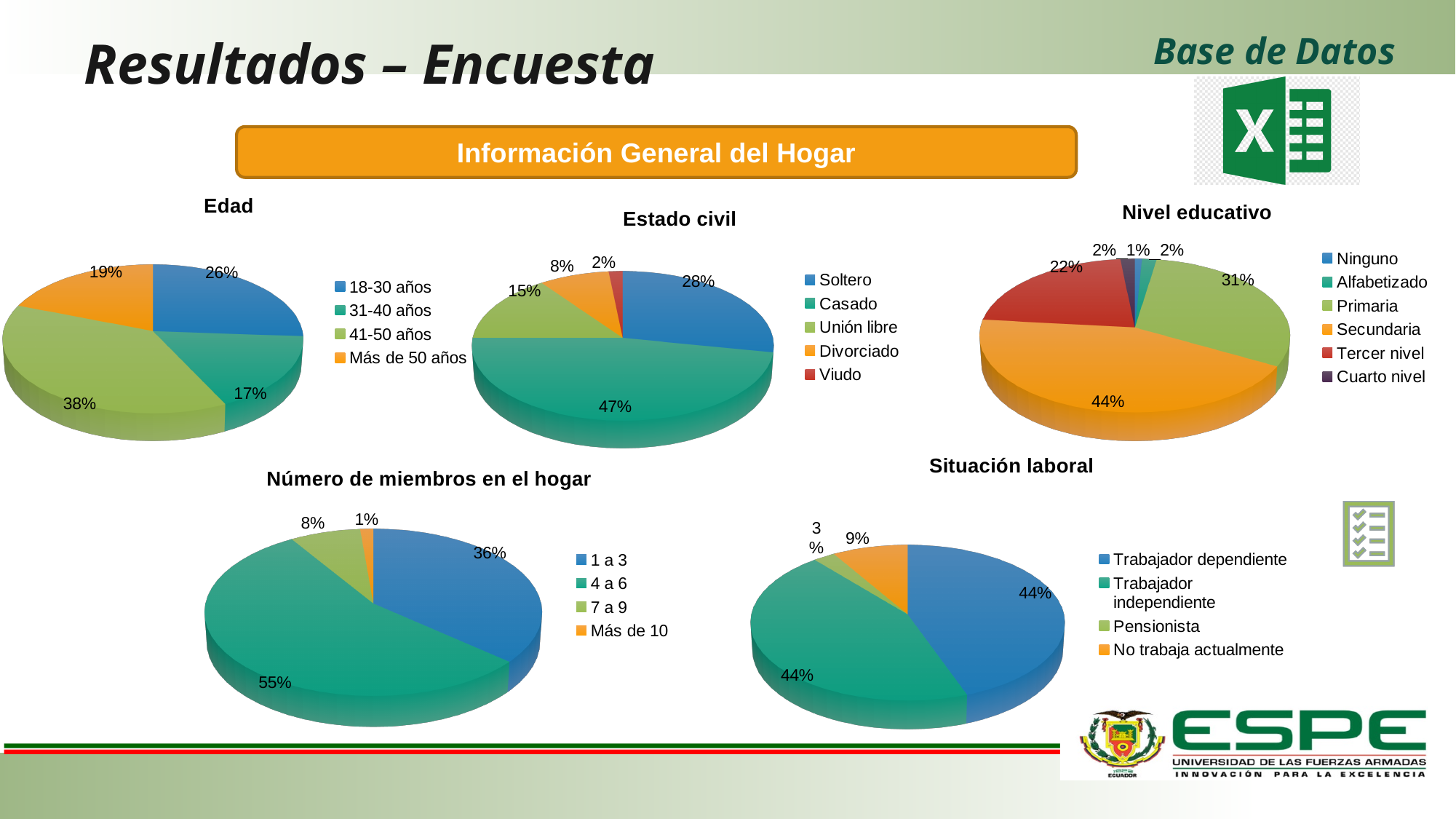
In the 'Nivel educativo' chart, which is larger, Primaria or Tercer nivel? Primaria In the 'Situación laboral' chart, what percentage is shown for No trabaja actualmente? 9% In the 'Número de miembros en el hogar' chart, what percentage is shown for 4 a 6? 55% In the 'Número de miembros en el hogar' chart, which category has the largest share? 4 a 6 How many pie charts are shown on the slide? 5 In the 'Edad' chart, which age group has the smallest share? 31-40 años In the 'Edad' chart, what percentage is shown for 41-50 años? 38% How many categories does the legend of the 'Estado civil' chart list? 5 In the 'Estado civil' chart, what is the difference between the Soltero and Unión libre shares? 13% In the 'Nivel educativo' chart, what percentage is shown for Secundaria? 44% What type of chart is used for 'Situación laboral'? Pie chart In the 'Estado civil' chart, what percentage is shown for Casado? 47%